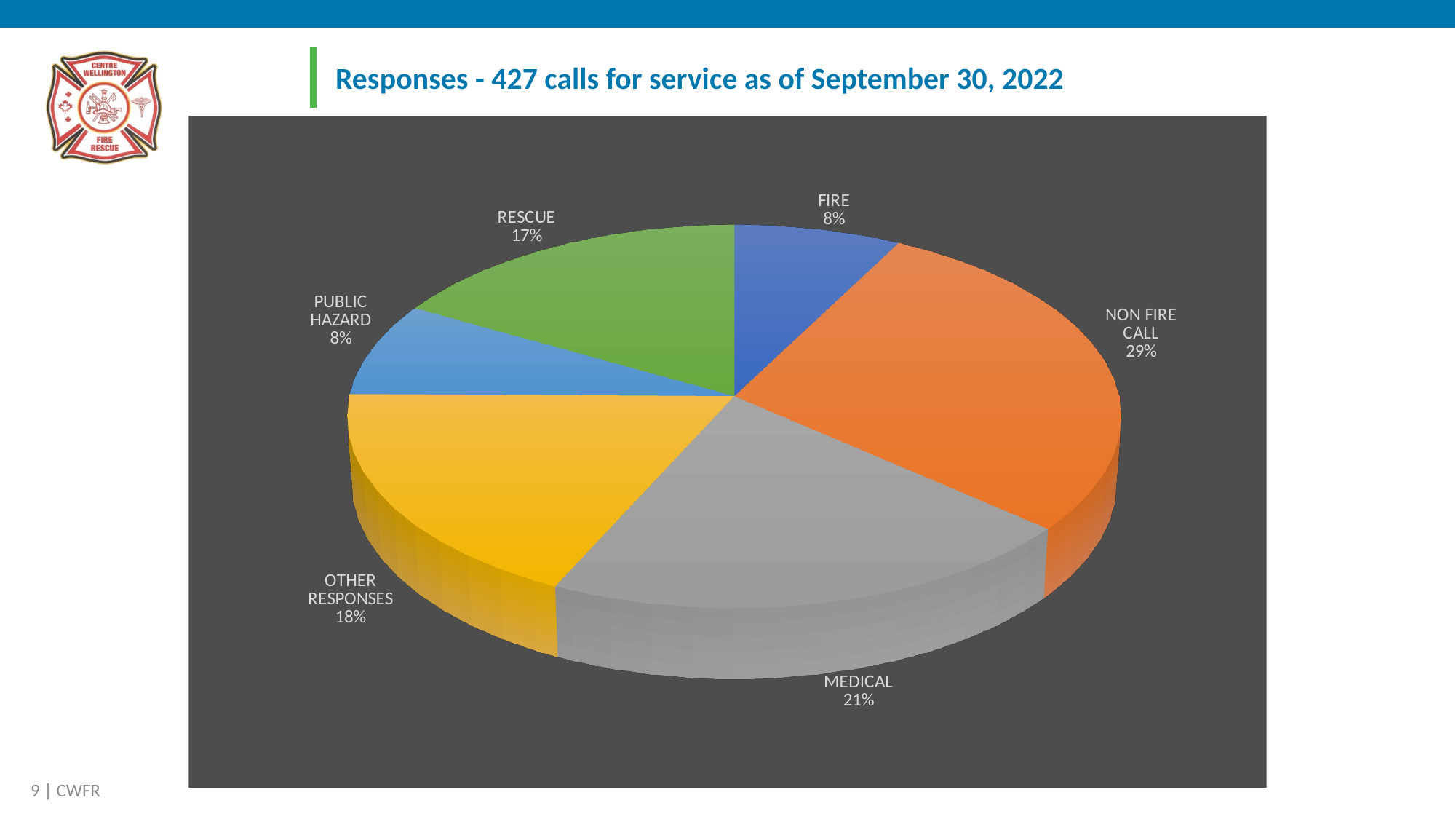
What is the difference in percentage points between NON FIRE CALL and MEDICAL? 8 What is the difference in percentage points between OTHER RESPONSES and FIRE? 10 What share of responses is OTHER RESPONSES? 18% Which is larger, the share for RESCUE or the share for MEDICAL? MEDICAL What share of responses is RESCUE? 17% What is the title of the chart on the slide? Responses - 427 calls for service as of September 30, 2022 How many categories are shown in the pie chart? 6 What share of responses is PUBLIC HAZARD? 8% What share of responses is NON FIRE CALL? 29% What kind of chart is shown on the slide? pie chart Which category has the largest share of responses? NON FIRE CALL What share of responses is MEDICAL? 21%